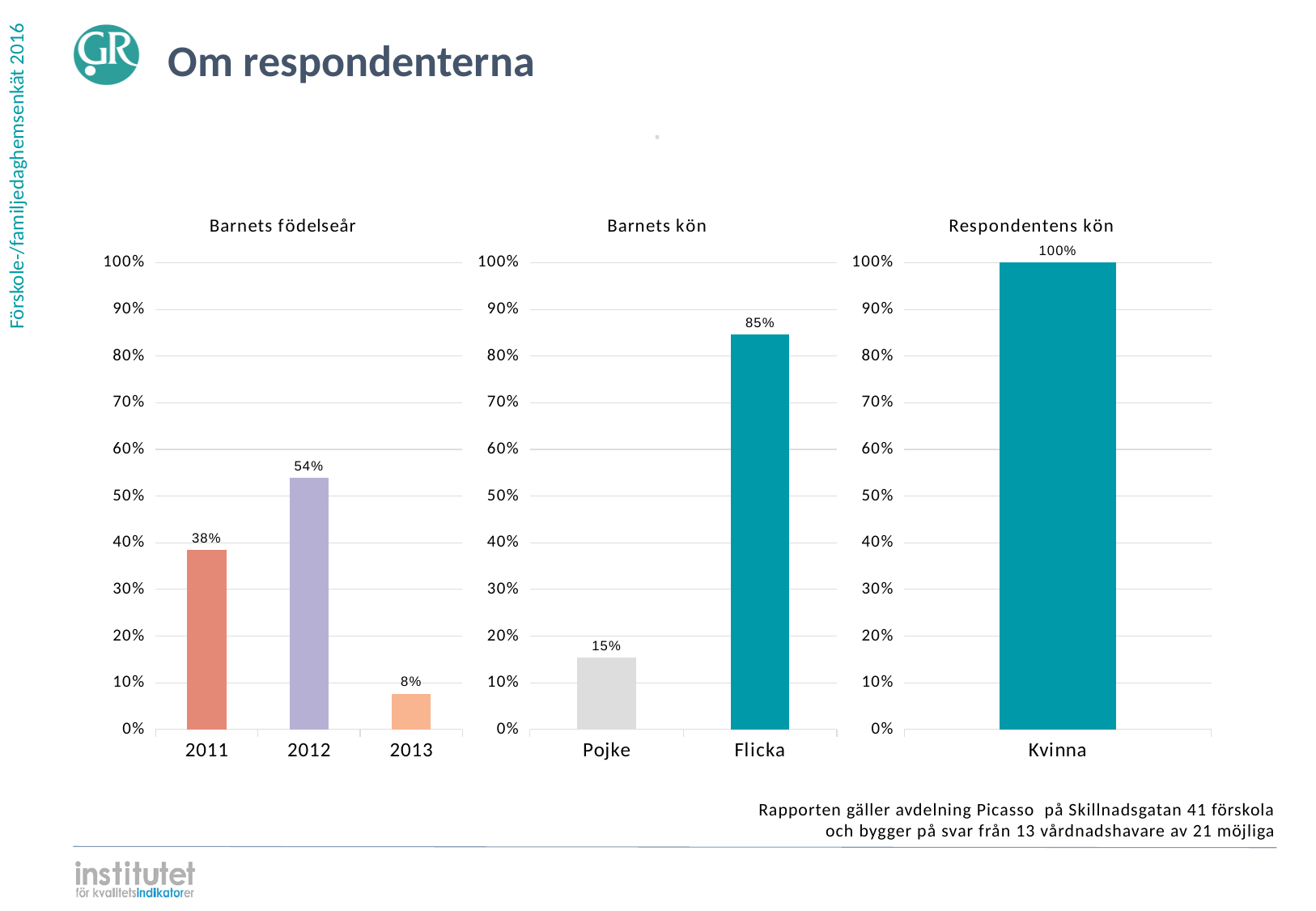
In the 'Barnets födelseår' chart, what is the difference between the values for 2012 and 2011? 16% In the 'Barnets födelseår' chart, is the value for 2011 greater or less than 40%? less In the 'Barnets kön' chart, what is the difference between the values for Flicka and Pojke? 70% In the 'Respondentens kön' chart, what is the value for Kvinna? 100% In the 'Barnets födelseår' chart, what is the value for 2013? 8% In the 'Barnets födelseår' chart, how many categories are shown on the x axis? 3 In the 'Barnets födelseår' chart, which birth year has the lowest value? 2013 In the 'Barnets kön' chart, what is the value for Pojke? 15% In the 'Barnets födelseår' chart, what is the value for 2012? 54% In the 'Barnets kön' chart, which is larger, Pojke or Flicka? Flicka What kind of chart is the 'Respondentens kön' chart? Bar chart In the 'Barnets födelseår' chart, which birth year has the highest value? 2012